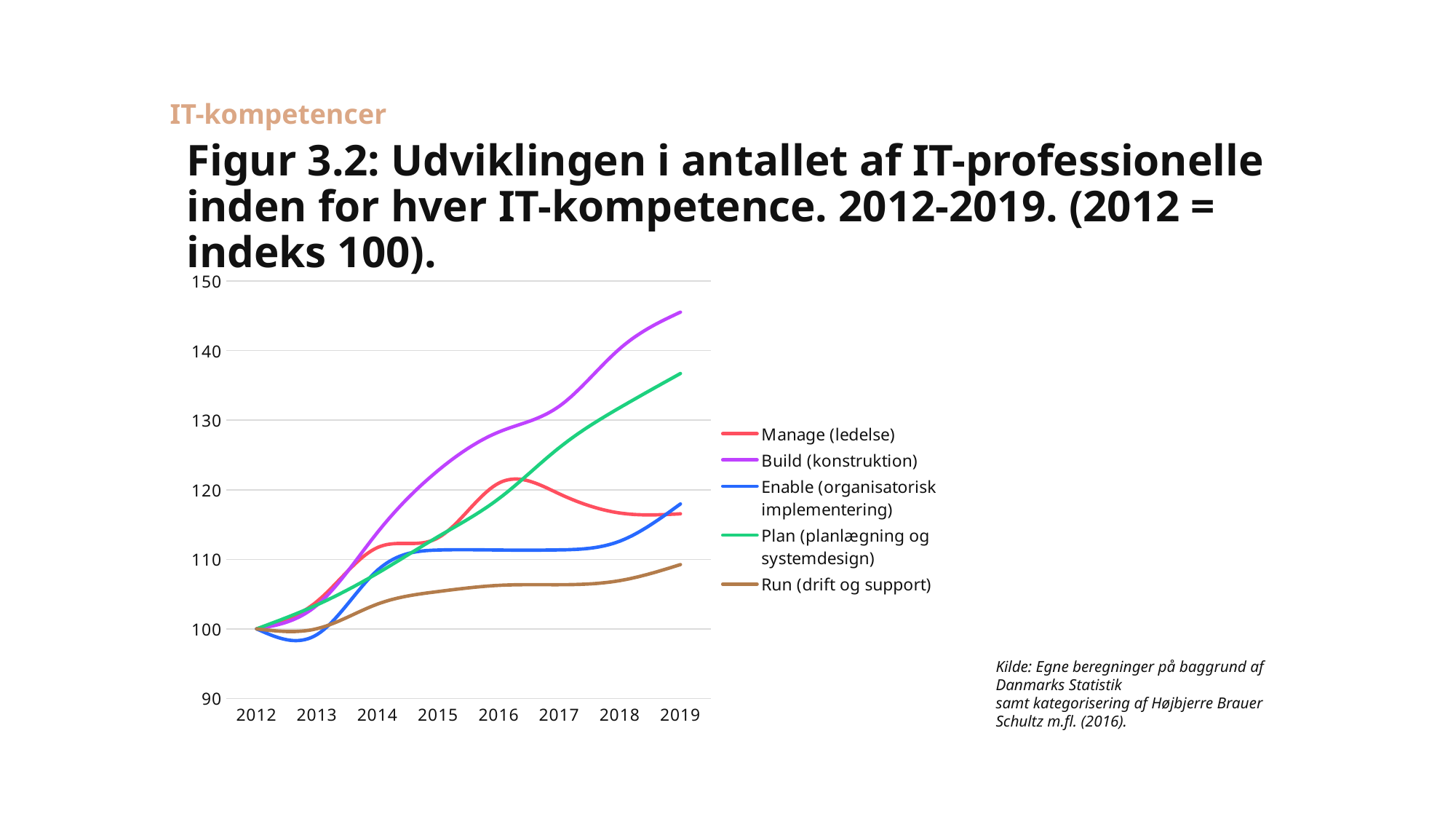
Is the value for Plan (planlægning og systemdesign) in 2018 greater or less than 130? greater Which is larger in 2019: Plan (planlægning og systemdesign) or Manage (ledelse)? Plan (planlægning og systemdesign) Is the value for Run (drift og support) in 2019 greater or less than 110? less What kind of chart is shown on the slide? line chart Which series has the highest value in 2019? Build (konstruktion) How many series does the legend list? 5 What is the index value of all series in 2012? 100 Which series has the lowest value in 2019? Run (drift og support) Which series is drawn in green? Plan (planlægning og systemdesign) How many years are shown along the x axis? 8 Does the Build (konstruktion) series rise or fall from 2012 to 2019? rise Is the value for Build (konstruktion) in 2019 greater or less than 140? greater